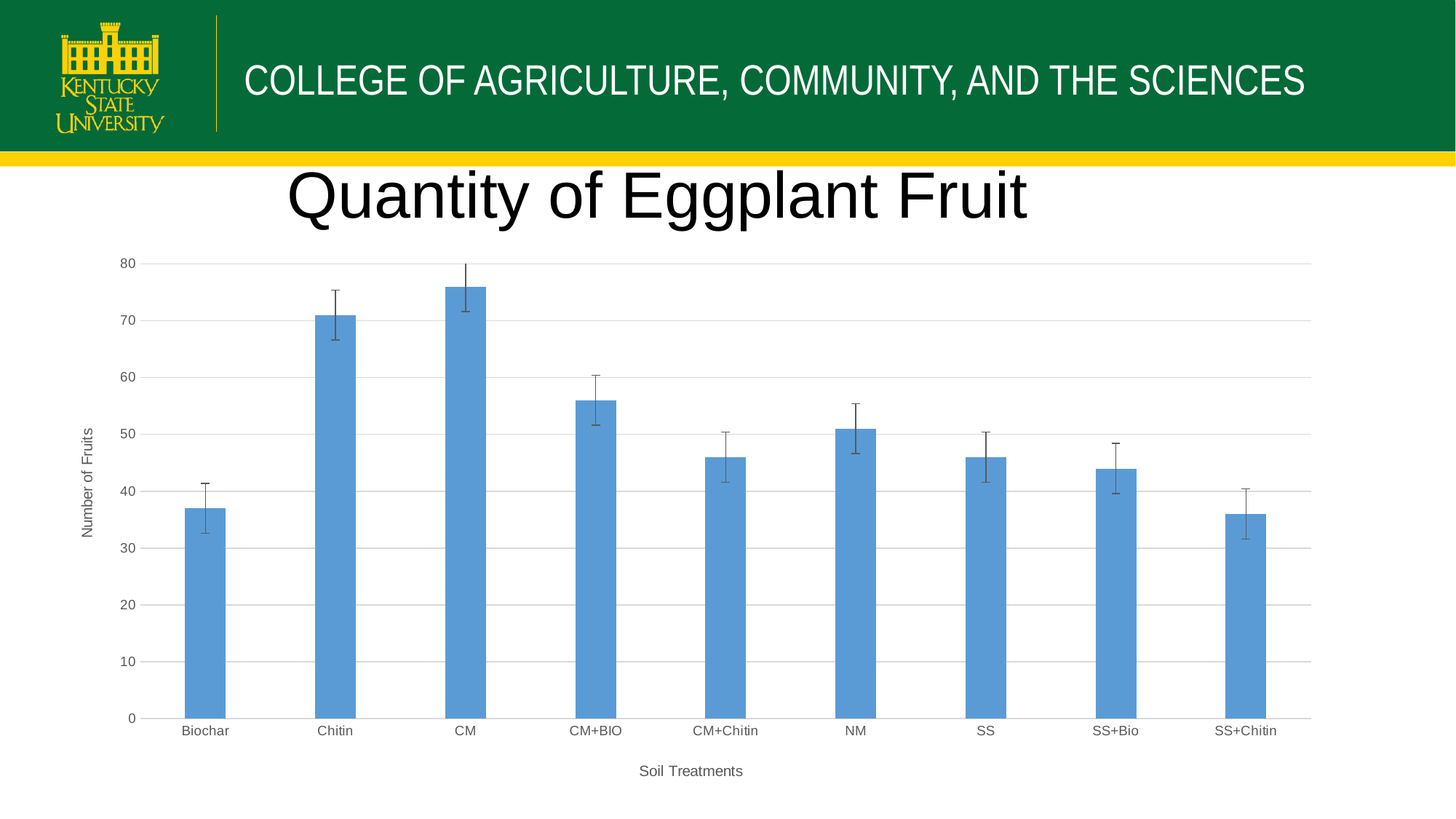
What is the label on the y axis? Number of Fruits What kind of chart is shown on the slide? bar chart What is the title of the chart? Quantity of Eggplant Fruit How many soil treatments are shown on the x axis? 9 Which soil treatment has the highest number of fruits? CM Is the value for CM greater or less than 70? greater Which has more fruits, NM or SS+Chitin? NM Is the value for CM+BIO greater or less than 50? greater Which has more fruits, Chitin or CM+BIO? Chitin Is the value for SS+Bio greater or less than 50? less